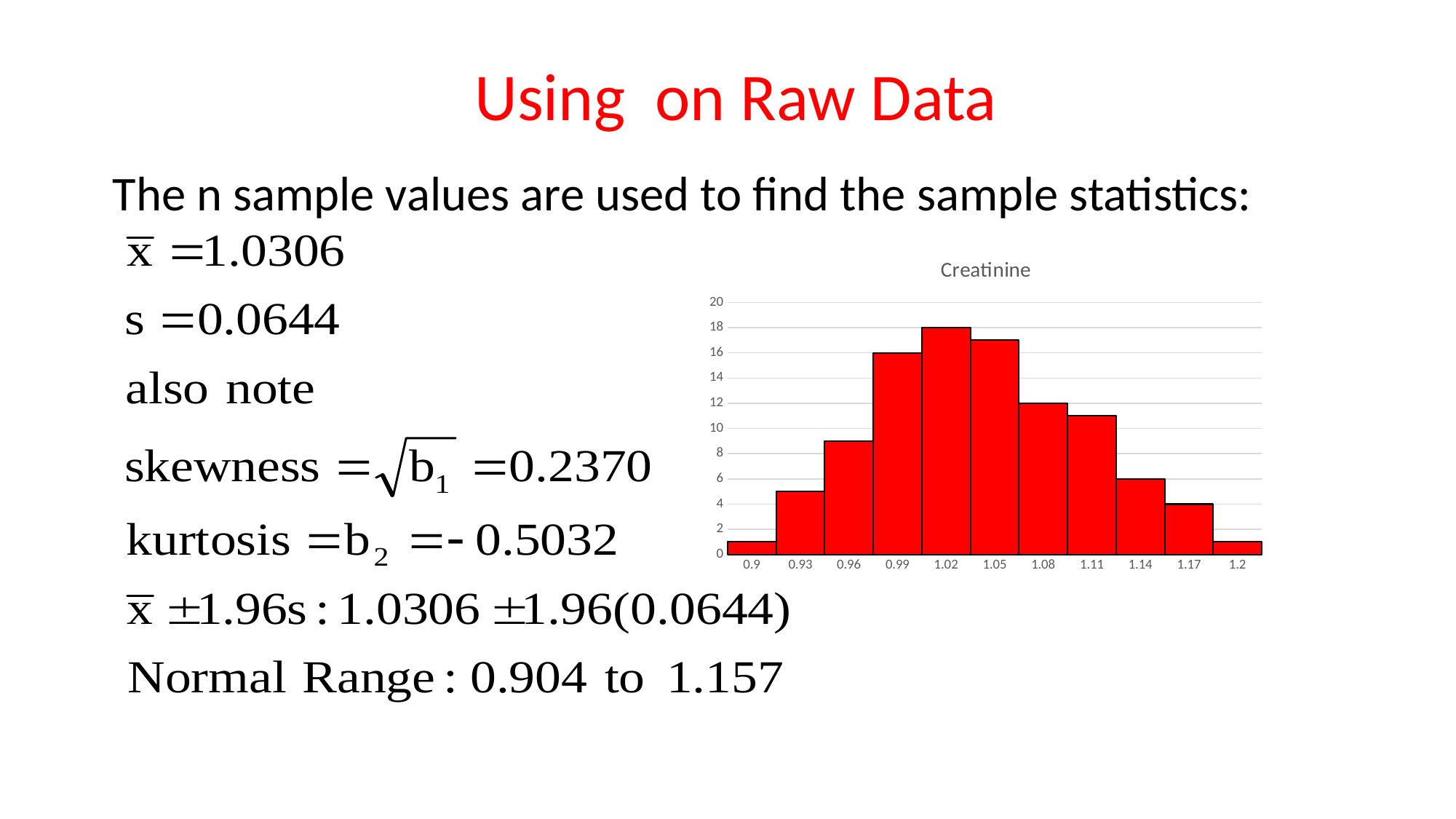
What is the value of the bar at 1.02? 18 What is the difference between the bars at 1.02 and 0.99? 2 What is the value of the bar at 0.99? 16 What kind of chart is shown on the slide? bar chart Which bar is taller, 0.99 or 1.08? 0.99 What is the value of the bar at 1.14? 6 Is the value for 0.96 greater or less than 10? less What is the value of the bar at 1.08? 12 How many bars are plotted in the chart? 11 Is the value for 1.05 greater or less than 16? greater What is the title of the chart? Creatinine Which category has the highest bar? 1.02